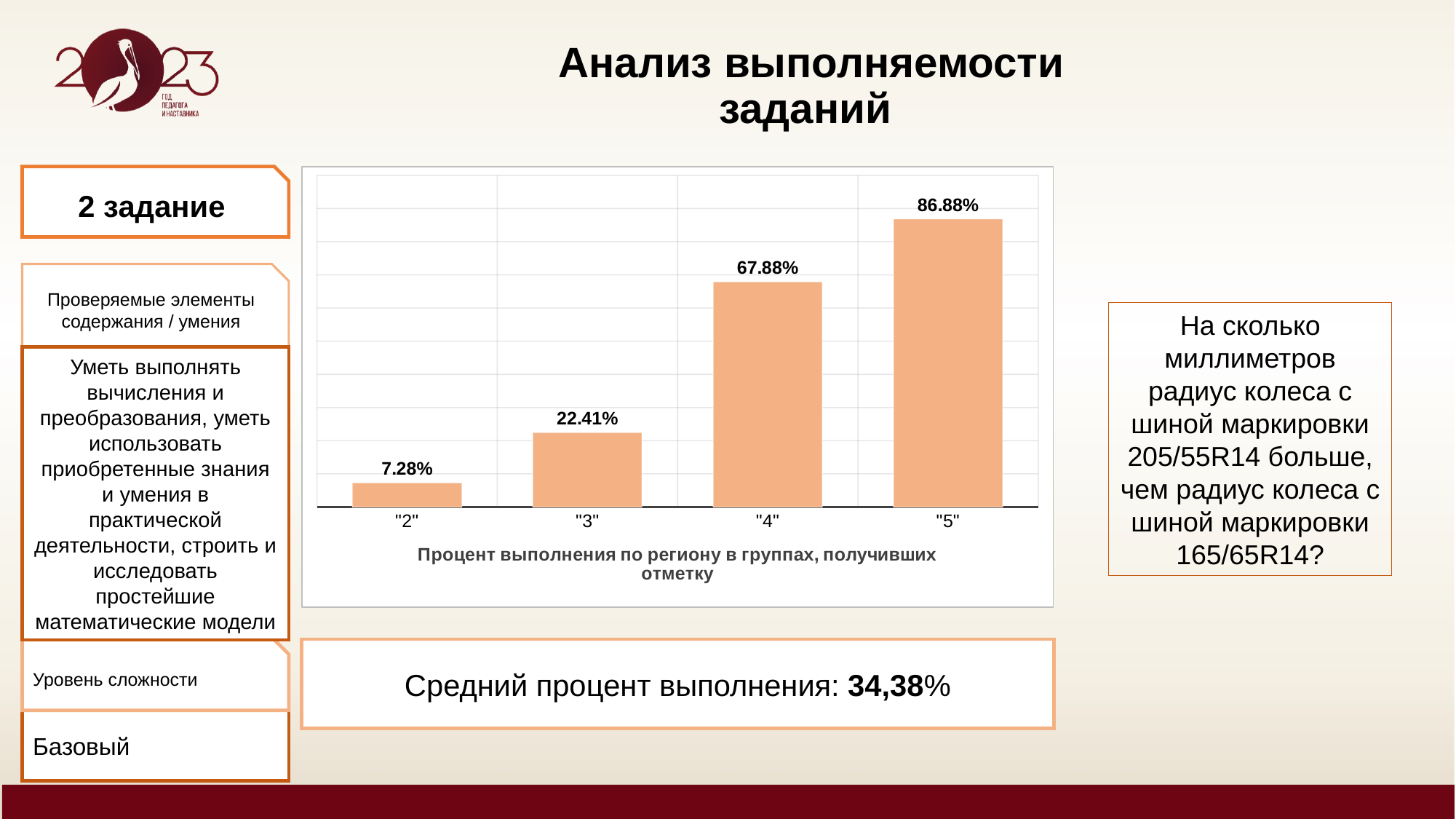
What is the difference between the values for groups "3" and "2"? 15.13% Which group has the lowest percentage? "2" Which is larger, the value for group "3" or the value for group "4"? "4" What is the value for the group with mark "2"? 7.28% Do the values rise or fall from left to right along the x axis? Rise What is the difference between the values for groups "5" and "4"? 19.00% What is the value for the group with mark "5"? 86.88% What is the value for the group with mark "3"? 22.41% Which group has the highest percentage? "5" What kind of chart is shown on the slide? Bar chart How many categories are shown on the x axis? 4 What is the value for the group with mark "4"? 67.88%